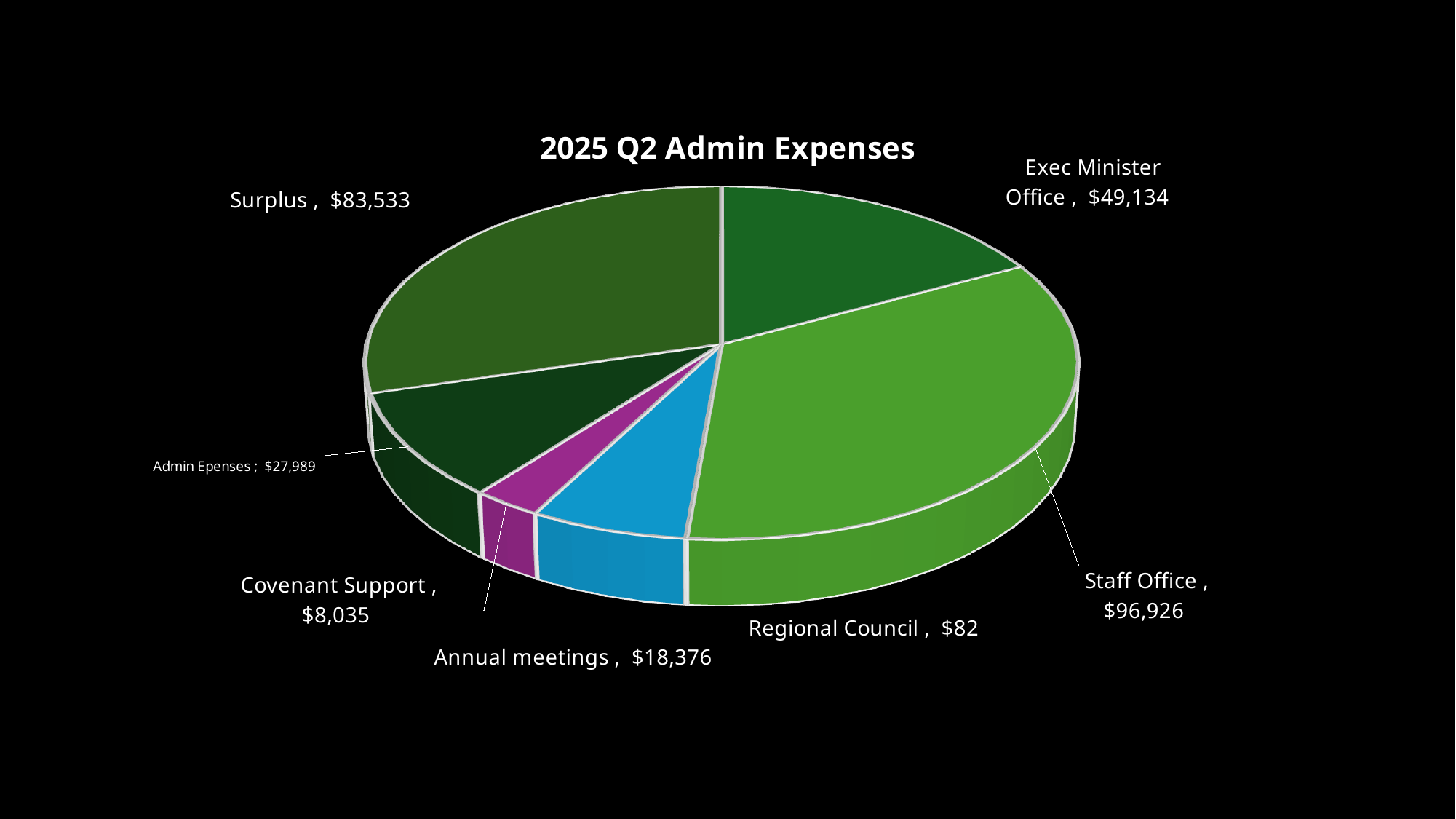
Which category has the smallest value? Regional Council What is the difference between the Staff Office value and the Surplus value? $13,393 Which category has the largest value? Staff Office What is the difference between the Exec Minister Office value and the Admin Epenses value? $21,145 What is the value for Annual meetings? $18,376 What kind of chart is shown on the slide? Pie chart What is the value for Admin Epenses? $27,989 What colour is the Annual meetings slice? Blue What is the title of the chart? 2025 Q2 Admin Expenses What is the value for Staff Office? $96,926 Which is larger, Surplus or Exec Minister Office? Surplus How many categories (slices) does the pie chart have? 7